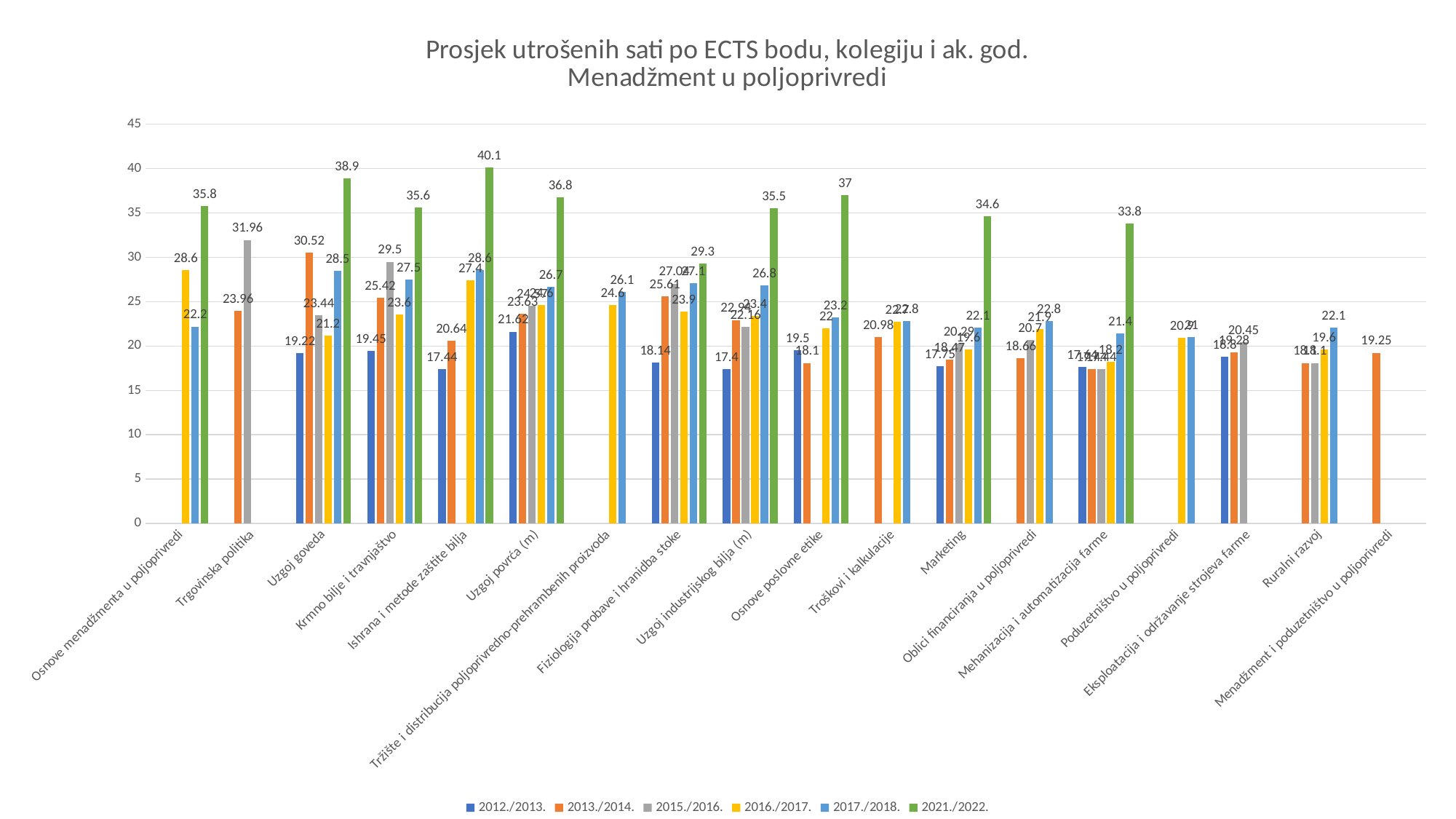
Is the 2021./2022. value for Osnove poslovne etike greater or less than 35? greater For Krmno bilje i travnjaštvo, which is larger: the 2015./2016. value or the 2017./2018. value? 2015./2016. Which category has the highest 2021./2022. value? Ishrana i metode zaštite bilja How many series does the legend list? 6 How many course categories are shown on the x axis? 18 What is the 2015./2016. value for Trgovinska politika? 31.96 What is the 2021./2022. value for Marketing? 34.6 For Uzgoj goveda, what is the difference between the 2021./2022. value and the 2012./2013. value? 19.68 What kind of chart is shown on the slide? bar chart What is the 2021./2022. value for Ishrana i metode zaštite bilja? 40.1 What is the 2013./2014. value for Menadžment i poduzetništvo u poljoprivredi? 19.25 What is the 2016./2017. value for Osnove menadžmenta u poljoprivredi? 28.6